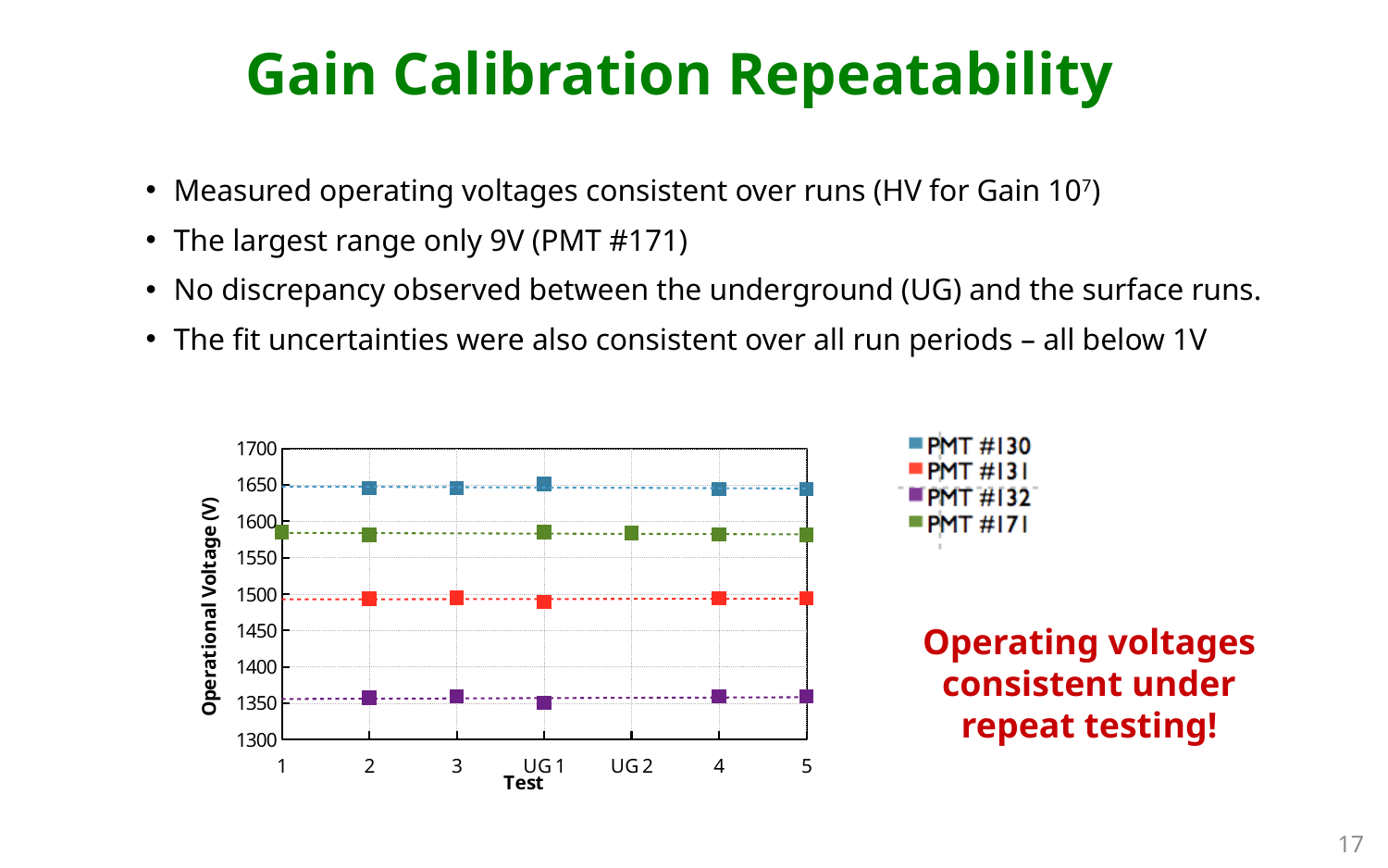
Is the value for PMT #131 at Test 3 greater or less than 1450? greater Which series has the larger operational voltage at Test 4, PMT #171 or PMT #131? PMT #171 Which series has the lowest operational voltage values in the chart? PMT #132 Do the operational voltages for PMT #130 rise, fall, or stay roughly flat across the tests? stay roughly flat What is the title of the y axis of the chart? Operational Voltage (V) Is the value for PMT #132 at Test 5 greater or less than 1400? less Which series has the highest operational voltage values in the chart? PMT #130 How many series does the chart legend list? 4 Is the value for PMT #171 at UG 2 greater or less than 1550? greater What is the title of the x axis of the chart? Test How many test categories are shown along the x axis of the chart? 7